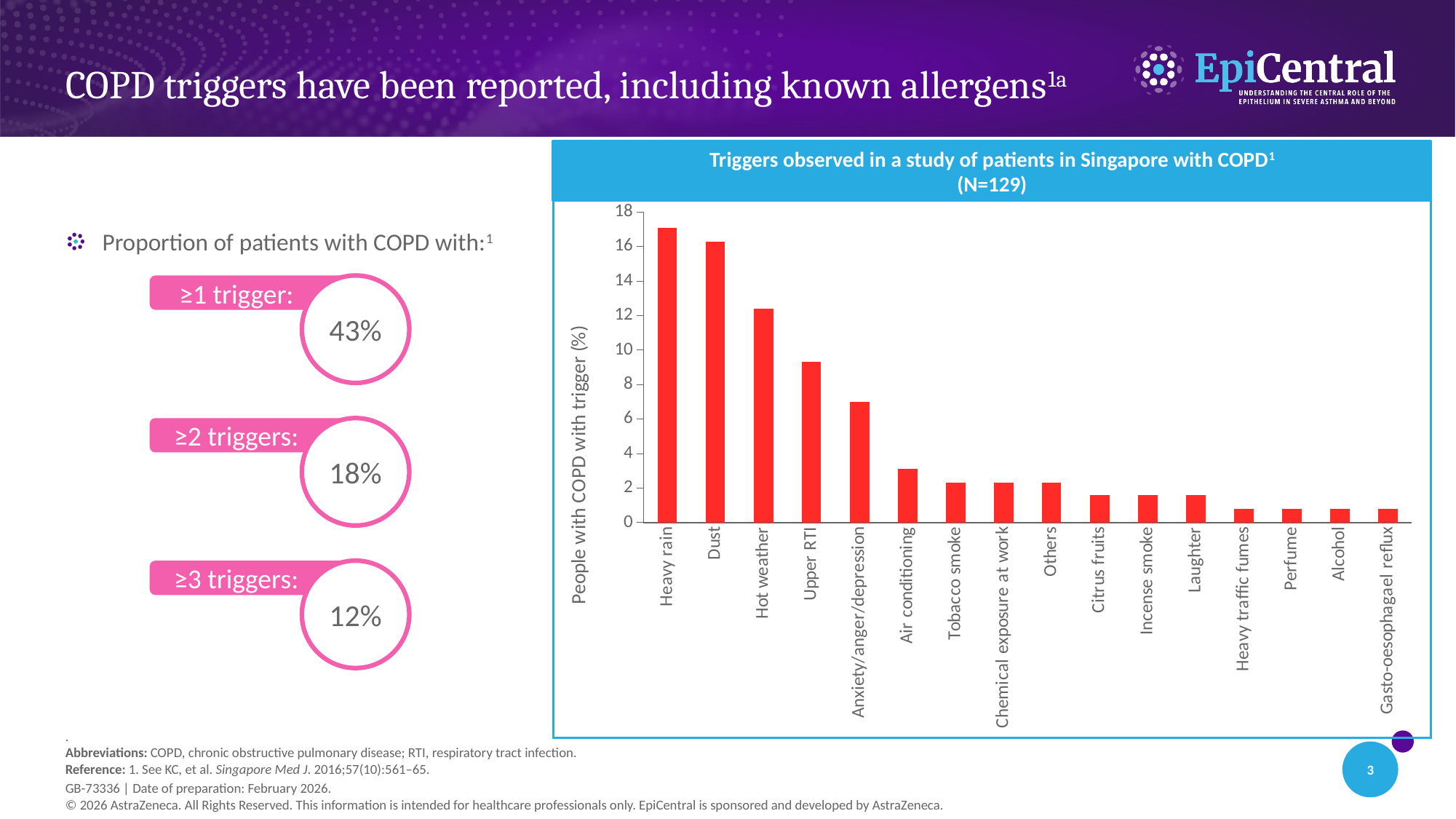
Is the value for Air conditioning greater or less than 4? less Is the value for Dust greater or less than 14? greater Is the value for Hot weather greater or less than 10? greater Which trigger has the highest percentage of people with COPD in the chart? Heavy rain Do the values rise or fall moving from left to right along the x axis? fall What kind of chart is shown on the slide? bar chart Which is larger, the value for Dust or the value for Hot weather? Dust What is the label on the y axis of the chart? People with COPD with trigger (%) How many trigger categories are plotted on the x axis of the chart? 16